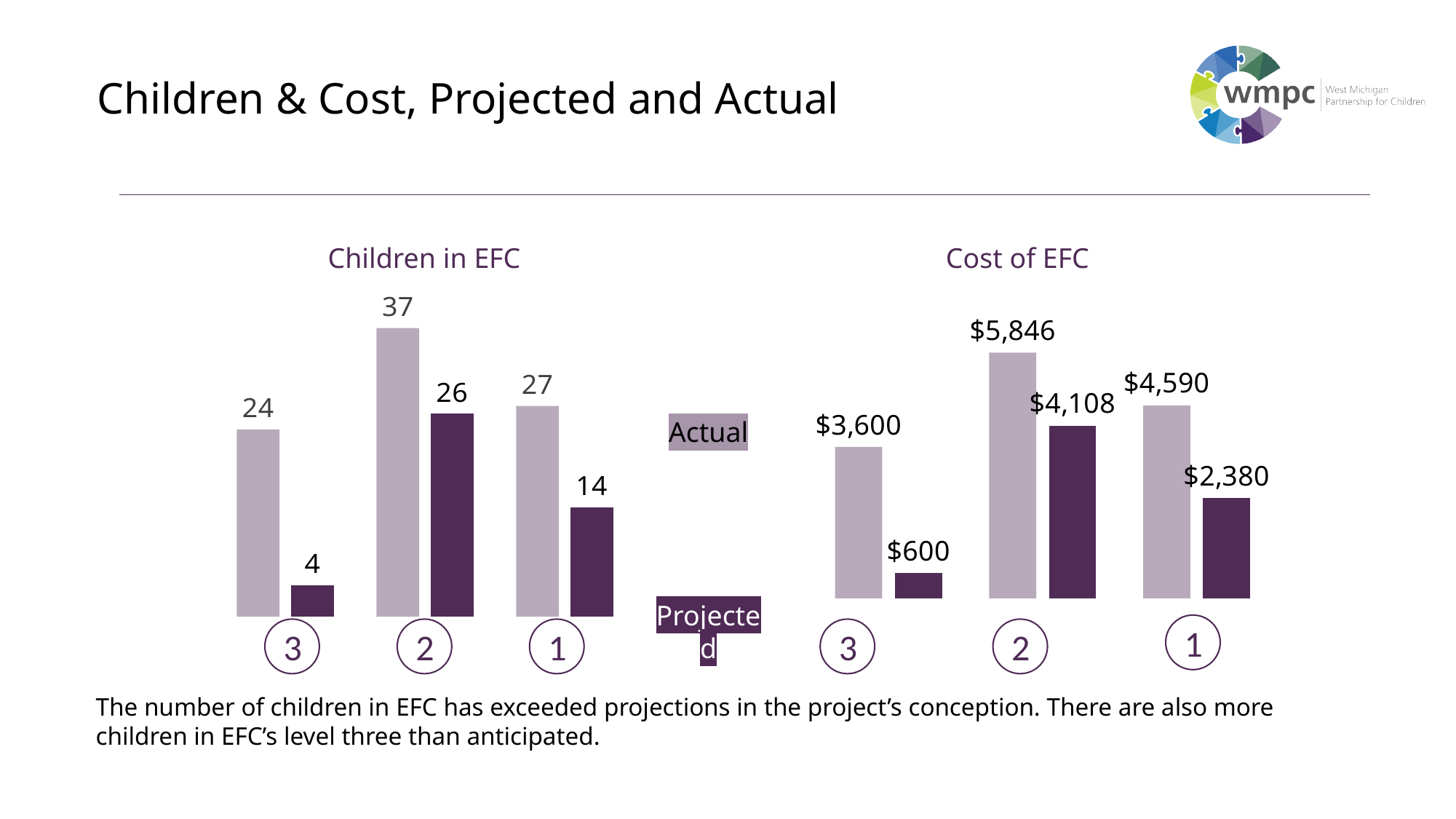
In the Cost of EFC chart, which level has the lowest Projected cost? 3 In the Children in EFC chart, which level has the highest Actual value? 2 What type of chart is the Cost of EFC chart? Bar chart In the Children in EFC chart, what is the Projected value for level 3? 4 In the Cost of EFC chart, what is the difference between the Actual and Projected costs for level 3? $3,000 How many series does the legend list for the charts? 2 In the Cost of EFC chart, what is the Projected cost for level 2? $4,108 In the Cost of EFC chart, which is larger: the Actual cost for level 1 or the Projected cost for level 2? Actual cost for level 1 In the Cost of EFC chart, what is the Actual cost for level 1? $4,590 In the Children in EFC chart, what is the Actual value for level 2? 37 In the Children in EFC chart, what is the difference between the Actual and Projected values for level 1? 13 How many levels are shown on the x axis of the Children in EFC chart? 3